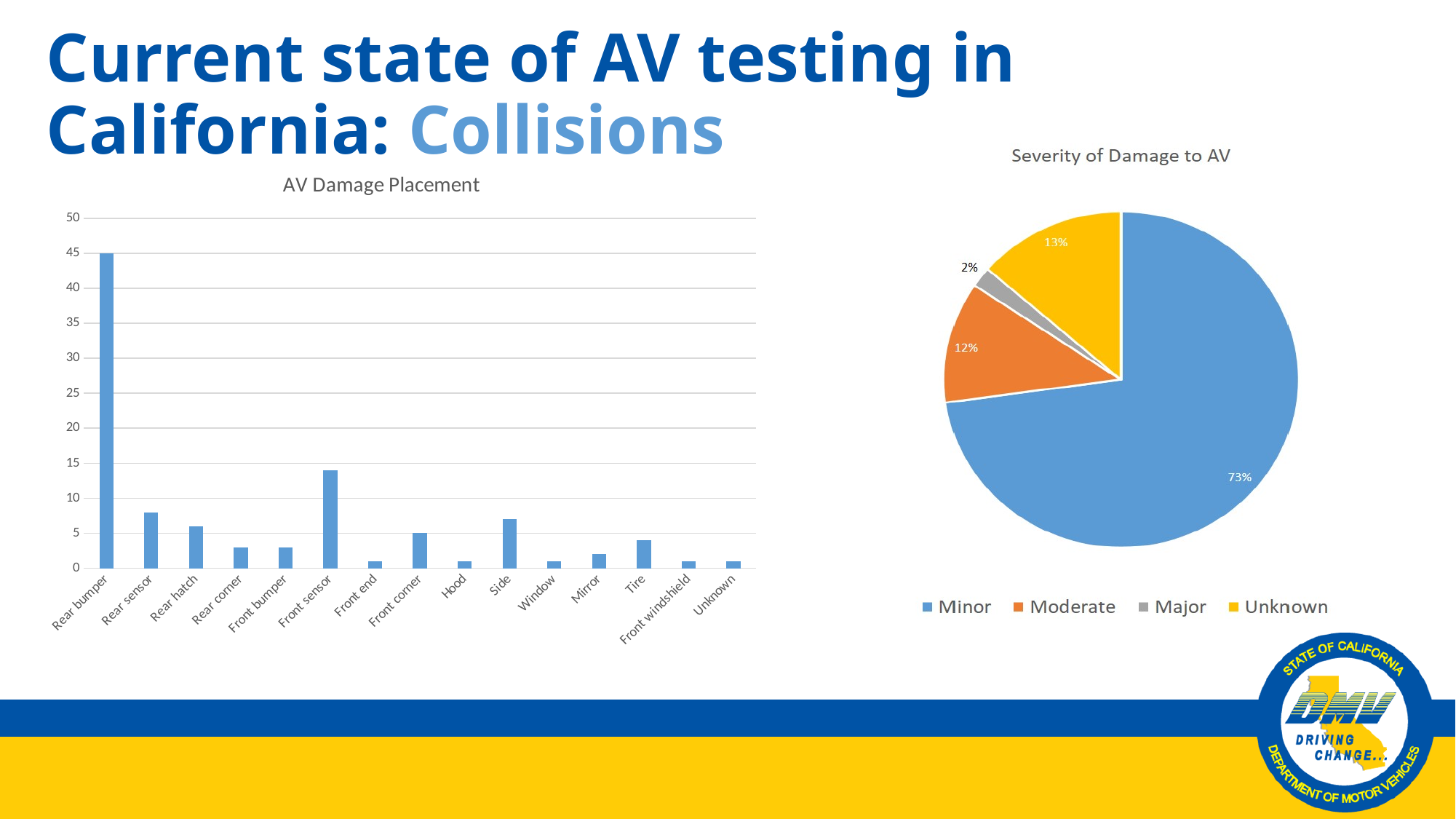
In the Severity of Damage to AV pie chart, which category has the smallest slice? Major How many entries does the legend of the Severity of Damage to AV chart list? 4 In the Severity of Damage to AV pie chart, what is the difference between the Unknown share and the Moderate share? 1% In the Severity of Damage to AV pie chart, what share is labelled for Minor? 73% In the AV Damage Placement chart, which category has the highest value? Rear bumper In the Severity of Damage to AV pie chart, what share is labelled for Moderate? 12% In the AV Damage Placement chart, what is the value for Rear bumper? 45 How many categories are shown on the x axis of the AV Damage Placement chart? 15 In the AV Damage Placement chart, is the value for Rear sensor greater or less than 10? less In the AV Damage Placement chart, which is larger, the value for Side or the value for Tire? Side In the AV Damage Placement chart, is the value for Front sensor greater or less than 10? greater What kind of chart is the AV Damage Placement chart? bar chart